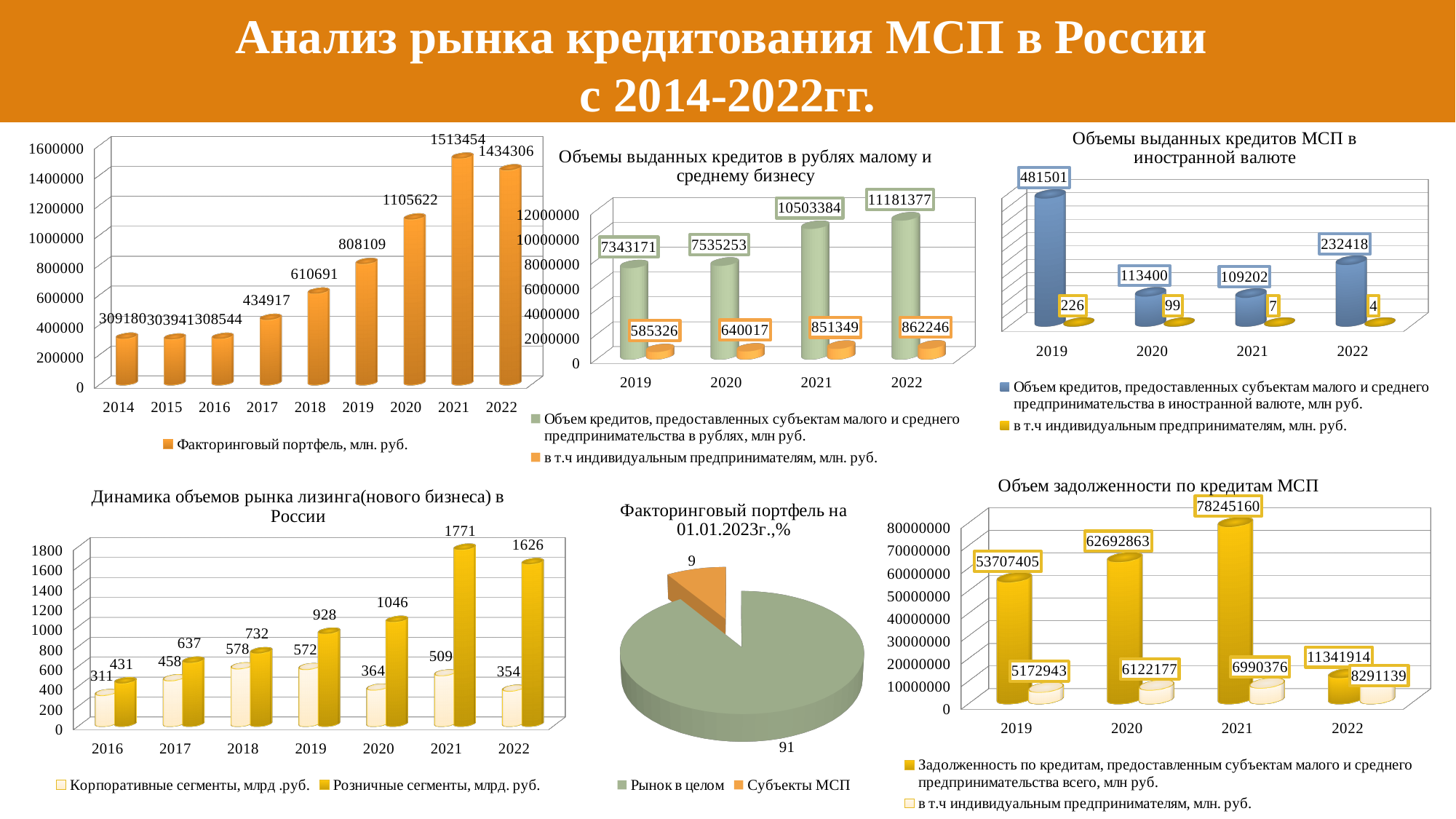
In the chart 'Объем задолженности по кредитам МСП', what is the value of 'в т.ч индивидуальным предпринимателям, млн. руб.' for 2021? 6990376 In the chart 'Объемы выданных кредитов в рублях малому и среднему бизнесу', what is the value of 'в т.ч индивидуальным предпринимателям, млн. руб.' for 2020? 640017 In the pie chart 'Факторинговый портфель на 01.01.2023г.,%', what share does 'Субъекты МСП' have? 9 In the chart 'Динамика объемов рынка лизинга(нового бизнеса) в России', what is the value of 'Розничные сегменты, млрд. руб.' for 2021? 1771 What type of chart is 'Факторинговый портфель на 01.01.2023г.,%'? Pie chart In the chart 'Динамика объемов рынка лизинга(нового бизнеса) в России', which is larger in 2019: 'Корпоративные сегменты' or 'Розничные сегменты'? Розничные сегменты In the top-left chart (Факторинговый портфель, млн. руб.), how many years are shown on the x axis? 9 In the chart 'Объемы выданных кредитов МСП в иностранной валюте', what is the value of 'в т.ч индивидуальным предпринимателям, млн. руб.' for 2022? 4 In the top-left chart (Факторинговый портфель, млн. руб.), which year has the lowest value? 2015 In the chart 'Объемы выданных кредитов в рублях малому и среднему бизнесу', what is the difference between the 2022 and 2021 values of 'Объем кредитов, предоставленных субъектам малого и среднего предпринимательства в рублях, млн руб.'? 677993 In the top-left chart (Факторинговый портфель, млн. руб.), what is the value for 2021? 1513454 In the chart 'Объемы выданных кредитов МСП в иностранной валюте', which year has the highest value for the blue series? 2019